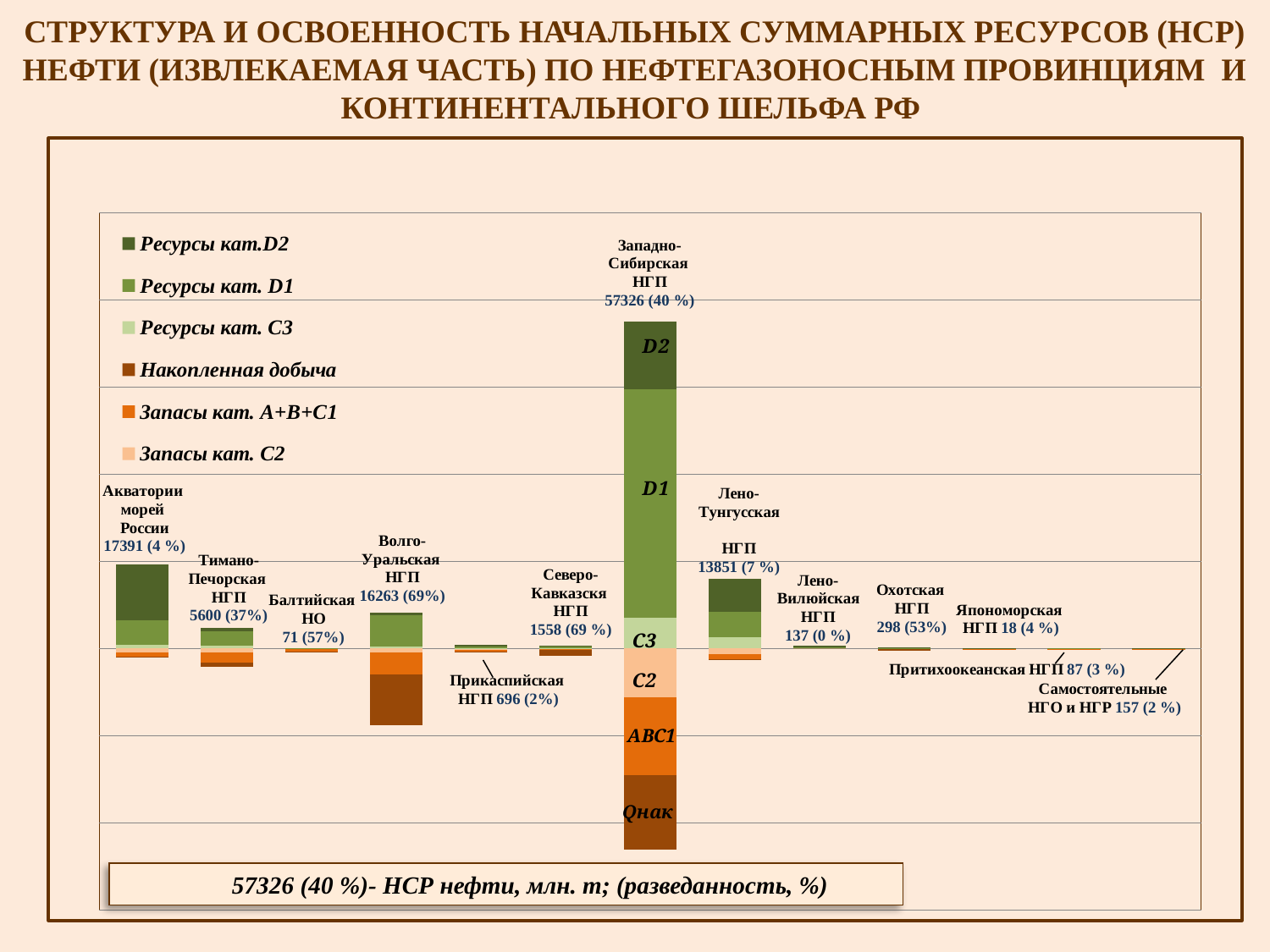
Which province has the lowest labeled НСР value? Япономорская НГП How many series does the legend list? 6 What value is labeled for Волго-Уральская НГП? 16263 (69%) What kind of chart is shown on the slide? stacked bar chart What value is labeled for Балтийская НО? 71 (57%) Which province has the highest labeled НСР value? Западно-Сибирская НГП What value is labeled for Западно-Сибирская НГП? 57326 (40 %) What value is labeled for Лено-Тунгусская НГП? 13851 (7 %) How many provinces (categories) are labeled on the chart? 13 What is the difference between the labeled values for Западно-Сибирская НГП and Волго-Уральская НГП? 41063 Which has the larger labeled value, Тимано-Печорская НГП or Прикаспийская НГП? Тимано-Печорская НГП Which legend entry is shown with the darkest green colour? Ресурсы кат.D2